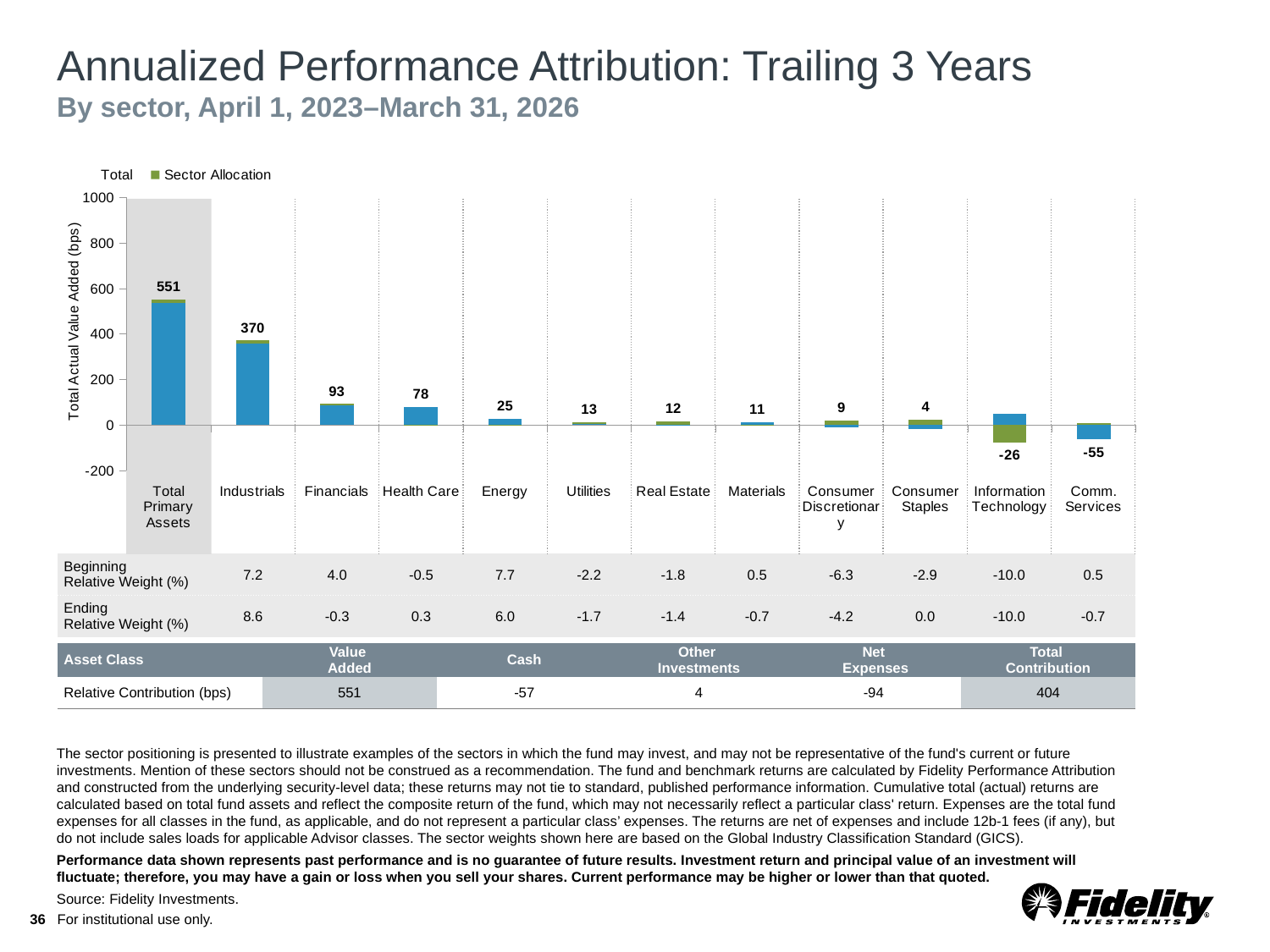
What is the total actual value added (bps) for Industrials? 370 What is the total actual value added (bps) for Comm. Services? -55 How many categories are shown on the x axis of the chart? 12 Is the value for Total Primary Assets greater or less than 600? less What is the total actual value added (bps) for Information Technology? -26 What is the difference between the total actual value added for Industrials and Financials? 277 Which category has the lowest total actual value added? Comm. Services What is the total actual value added (bps) for Financials? 93 Which has a higher total actual value added, Health Care or Energy? Health Care How many series does the chart legend list? 2 What kind of chart is shown on the slide? Bar chart Which sector (excluding Total Primary Assets) has the highest total actual value added? Industrials